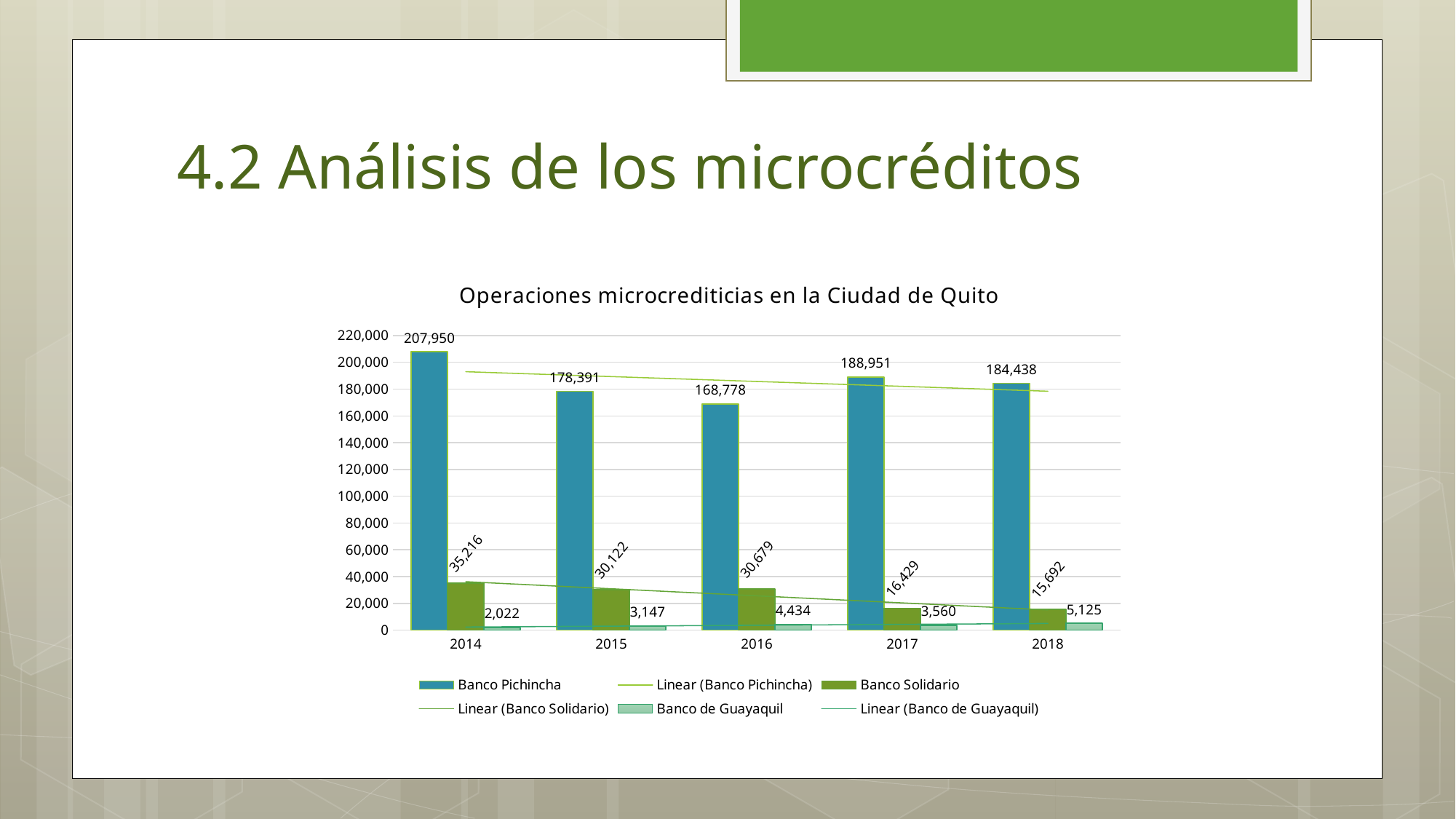
In which year is the value for Banco Solidario highest? 2014 In which year is the value for Banco Pichincha lowest? 2016 What kind of chart is shown on the slide? Bar chart What is the title of the chart? Operaciones microcrediticias en la Ciudad de Quito How many years are shown on the x axis? 5 What is the value for Banco Solidario in 2017? 16,429 How many entries does the legend list? 6 In which year is the value for Banco de Guayaquil lowest? 2014 What is the value for Banco Pichincha in 2014? 207,950 What is the difference between the Banco Pichincha values for 2014 and 2015? 29,559 Which is larger, the Banco Solidario value for 2015 or for 2016? 2016 What is the value for Banco de Guayaquil in 2018? 5,125